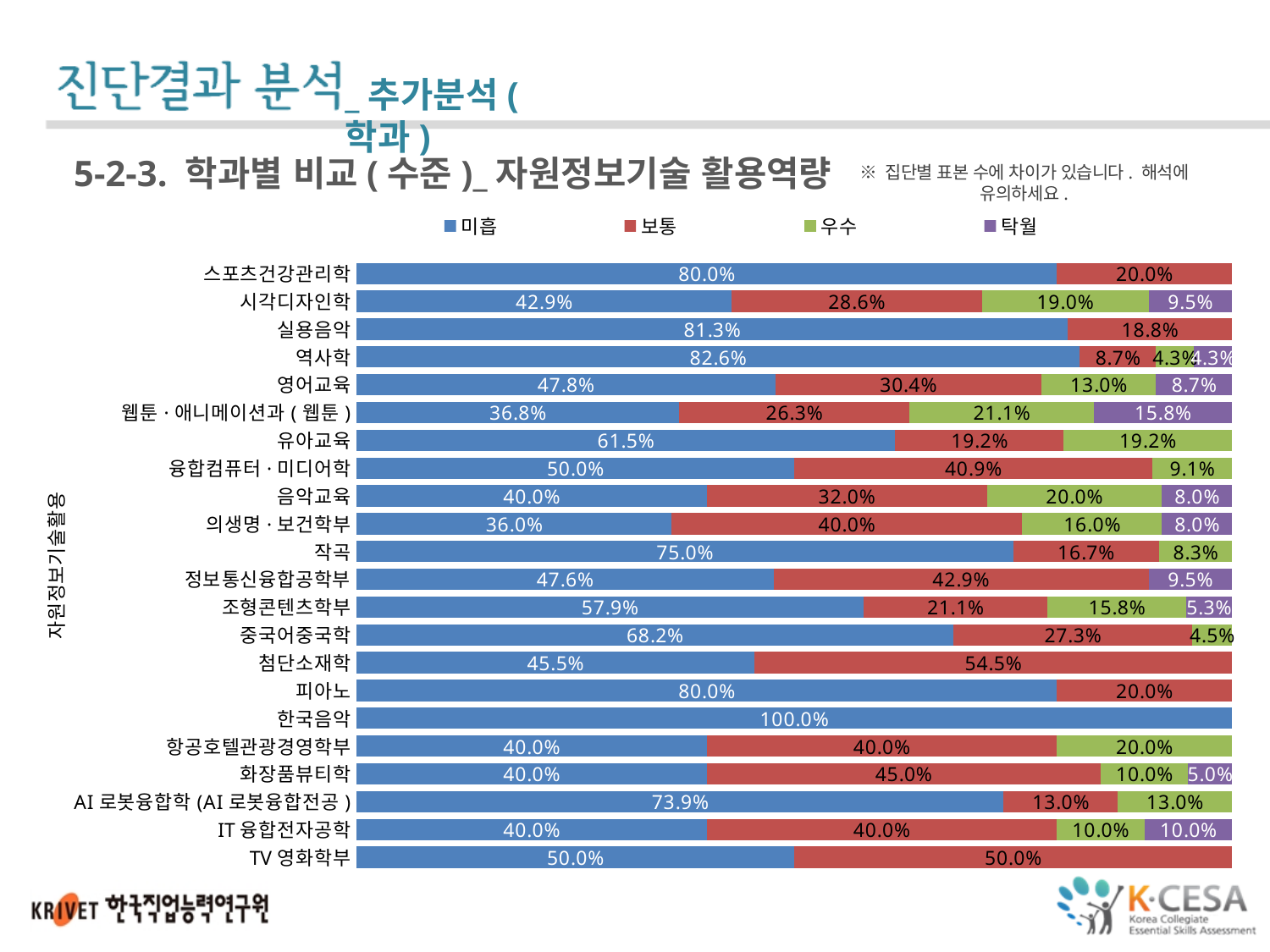
What is the total of the stacked bar for TV 영화학부? 100.0% How many departments (categories) are plotted in the chart? 22 What is the difference between the 미흡 and 보통 values for 시각디자인학? 14.3% What is the 미흡 value for 역사학? 82.6% Which department has the highest 미흡 value? 한국음악 What kind of chart is shown on the slide? Stacked bar chart What is the 탁월 value for 웹툰·애니메이션과(웹툰)? 15.8% Which is larger, the 미흡 value for 작곡 or the 미흡 value for 조형콘텐츠학부? 작곡 Which department has the highest 보통 value? 첨단소재학 How many series does the legend list? 4 What is the 보통 value for 융합컴퓨터·미디어학? 40.9% Which legend entry is shown in green? 우수